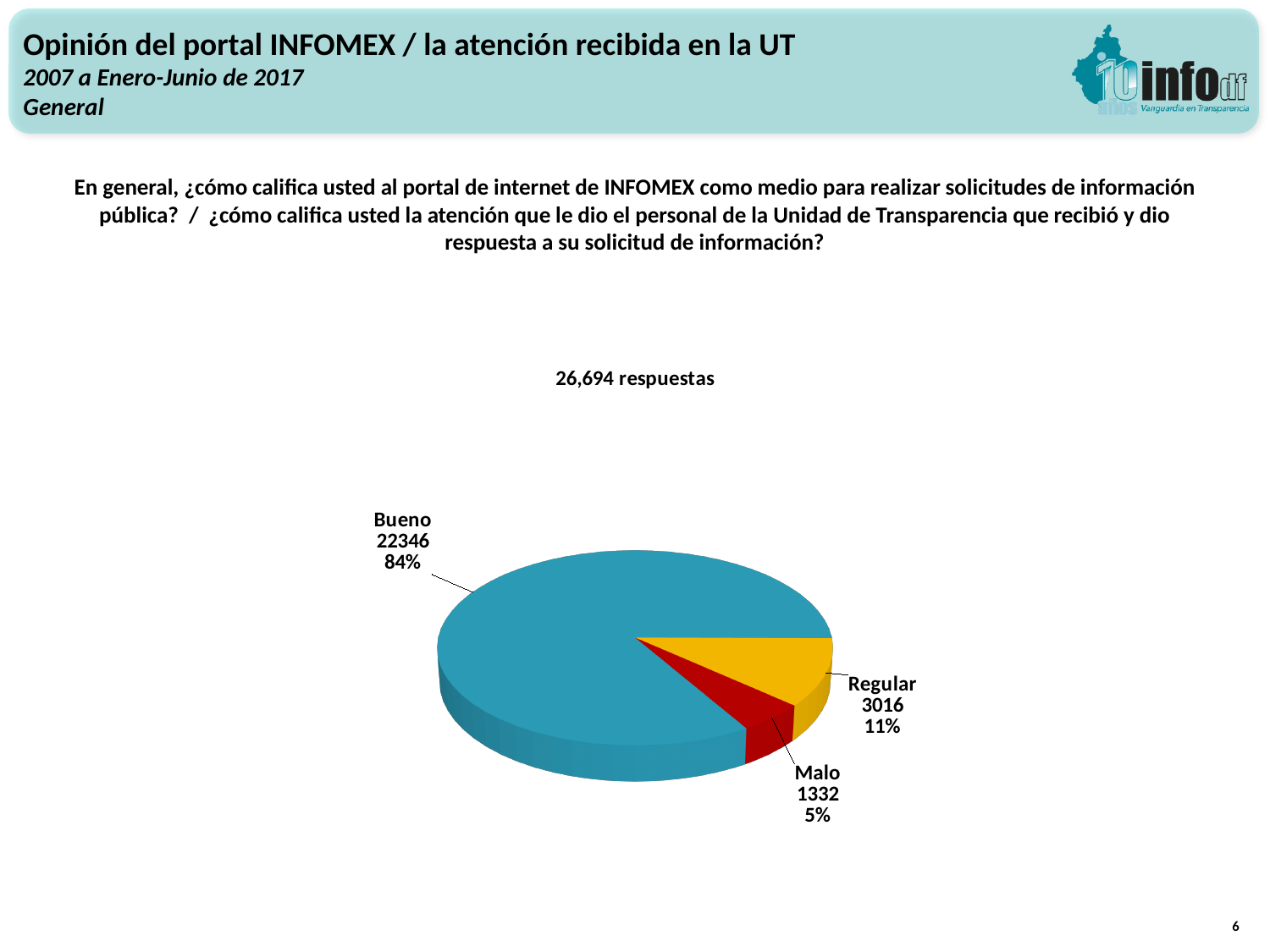
How many responses does the chart report in total? 26,694 respuestas What kind of chart is shown on the slide? pie chart What share of the pie does the Malo slice represent? 5% How many responses are labelled Bueno? 22346 How many responses are labelled Regular? 3016 What is the difference in responses between Regular and Malo? 1684 Which category has the largest slice of the pie? Bueno Which has more responses, Regular or Malo? Regular How many responses are labelled Malo? 1332 How many categories are shown in the pie chart? 3 What share of the pie does the Bueno slice represent? 84% Which category has the smallest slice of the pie? Malo